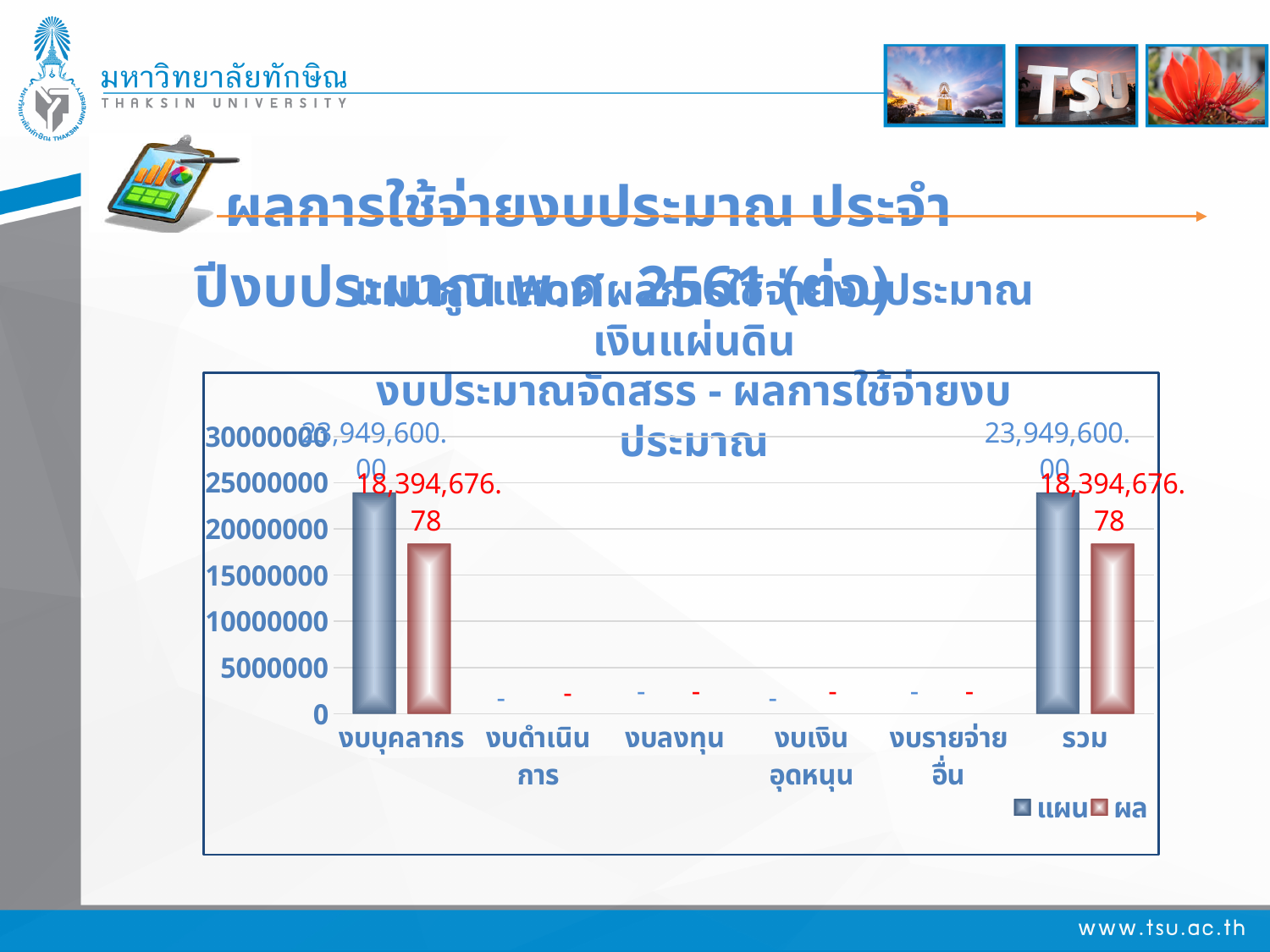
How many series does the legend list? 2 What is the value of ผล for งบบุคลากร? 18,394,676.78 What is the difference between แผน and ผล for รวม? 5,554,923.22 How many categories are shown on the x axis? 6 What type of chart is shown on the slide? bar chart Is the value of ผล for งบบุคลากร greater or less than 20000000? less What is the value of แผน for งบบุคลากร? 23,949,600.00 What is the title of the chart? งบประมาณจัดสรร - ผลการใช้จ่ายงบประมาณ Which is larger for งบบุคลากร, แผน or ผล? แผน What are the two series names in the legend? แผน and ผล What is the value of ผล for รวม? 18,394,676.78 What is the value of แผน for รวม? 23,949,600.00